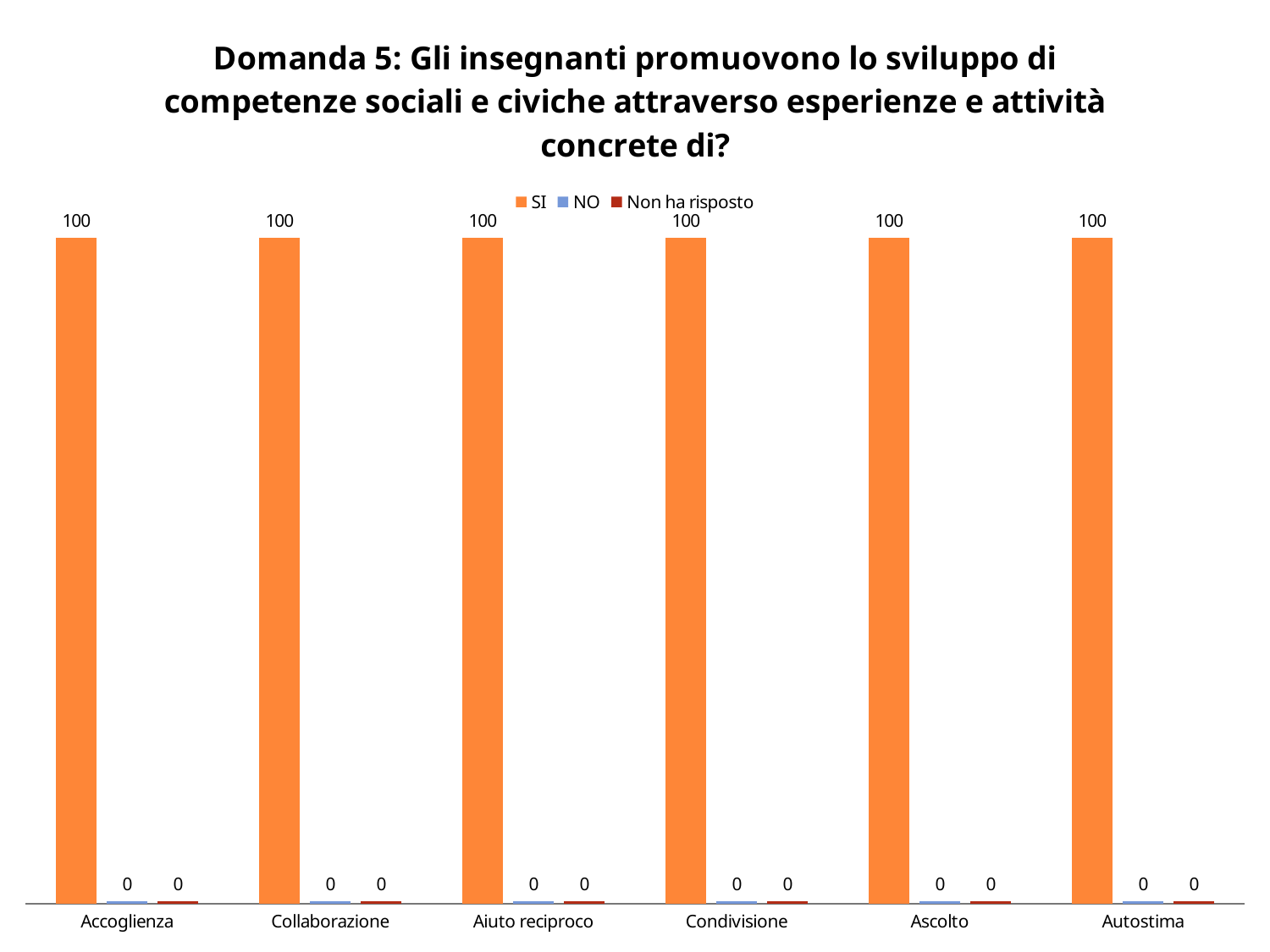
How many categories are shown on the x axis? 6 What is the difference between the SI value and the NO value for Aiuto reciproco? 100 What is the total of the SI, NO and Non ha risposto values for Accoglienza? 100 What is the value of the Non ha risposto series for Autostima? 0 What kind of chart is shown on the slide? bar chart What is the value of the SI series for Accoglienza? 100 How many series does the legend list? 3 Which is larger for Condivisione, the SI value or the NO value? SI What is the value of the NO series for Collaborazione? 0 What colour are the bars for the SI series? orange What is the value of the SI series for Ascolto? 100 Which series has the highest value for Autostima? SI